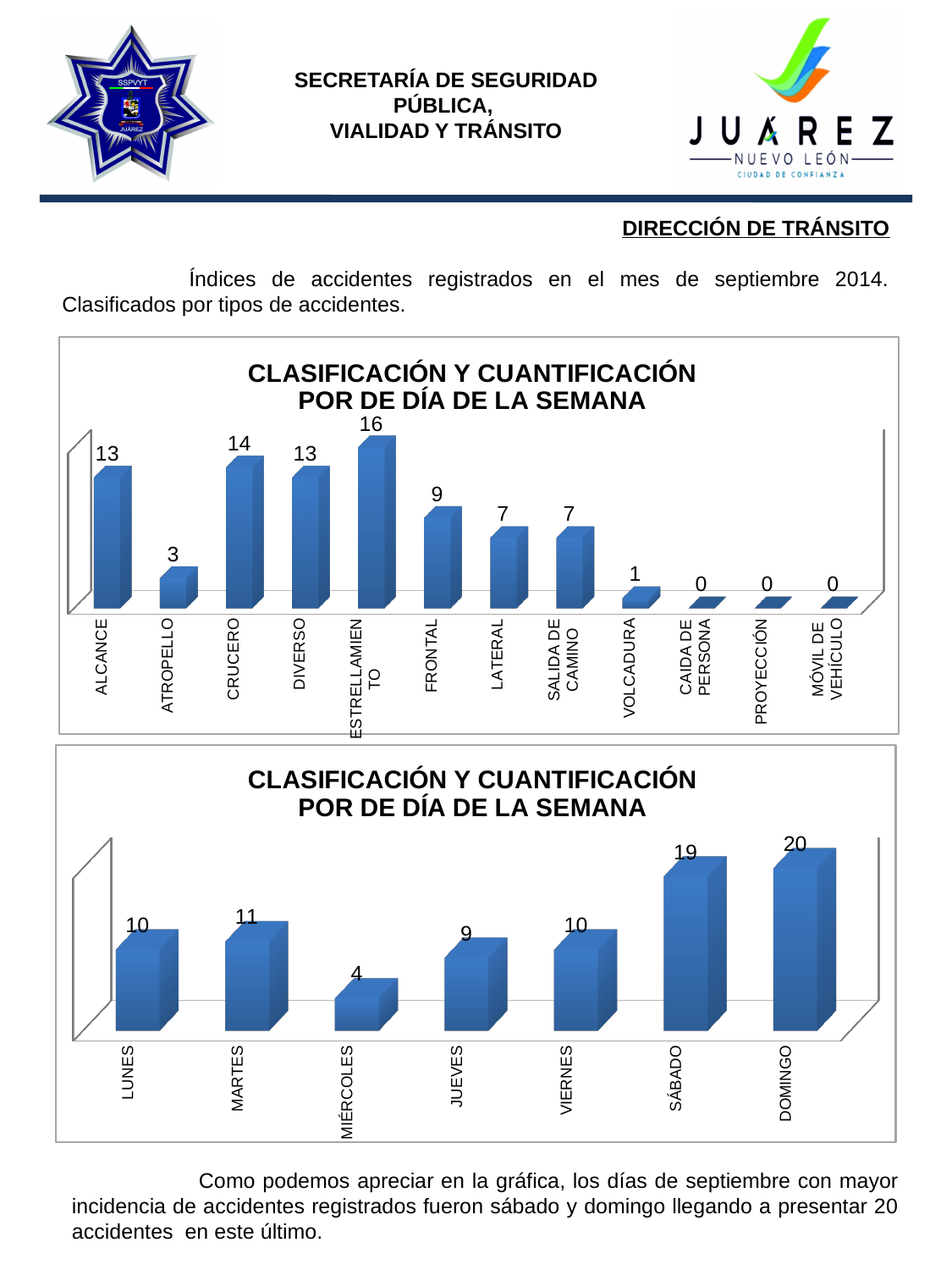
In the bottom chart, what is the difference between the values for SÁBADO and MIÉRCOLES? 15 What is the title of the bottom chart? CLASIFICACIÓN Y CUANTIFICACIÓN POR DE DÍA DE LA SEMANA In the bottom chart, how many days are shown on the x axis? 7 In the top chart, what is the difference between the values for CRUCERO and FRONTAL? 5 In the bottom chart, which day has the lowest value? MIÉRCOLES What kind of chart is the bottom chart? Bar chart In the top chart, what is the value for ESTRELLAMIENTO? 16 In the top chart, what is the value for ATROPELLO? 3 In the top chart, how many categories are shown on the x axis? 12 In the bottom chart, what is the value for DOMINGO? 20 In the top chart, which is larger, the value for LATERAL or the value for VOLCADURA? LATERAL In the top chart, which category has the highest value? ESTRELLAMIENTO